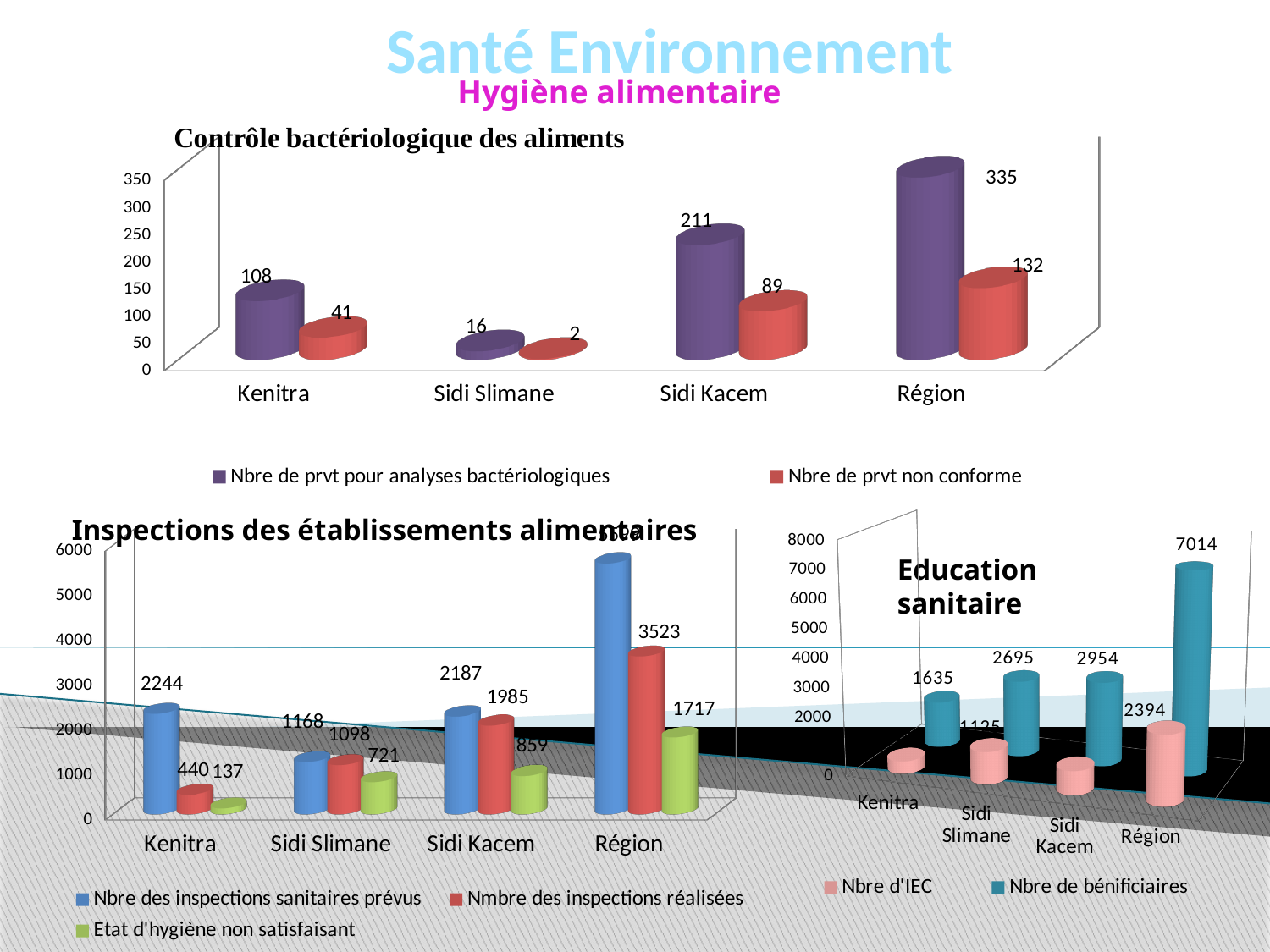
In the 'Education sanitaire' chart, which category has the highest value for 'Nbre de bénificiaires'? Région In the 'Inspections des établissements alimentaires' chart, how many categories are shown on the x axis? 4 In the 'Contrôle bactériologique des aliments' chart, what is the difference between 'Nbre de prvt pour analyses bactériologiques' and 'Nbre de prvt non conforme' for Région? 203 In the 'Contrôle bactériologique des aliments' chart, which category has the lowest value for 'Nbre de prvt pour analyses bactériologiques'? Sidi Slimane What kind of chart is the 'Education sanitaire' chart? Bar chart In the 'Education sanitaire' chart, what is the value of 'Nbre de bénificiaires' for Région? 7014 In the 'Inspections des établissements alimentaires' chart, which is larger for Sidi Kacem: 'Nmbre des inspections réalisées' or 'Etat d'hygiène non satisfaisant'? Nmbre des inspections réalisées In the 'Inspections des établissements alimentaires' chart, what is the value of 'Nbre des inspections sanitaires prévus' for Kenitra? 2244 In the 'Contrôle bactériologique des aliments' chart, how many series does the legend list? 2 In the 'Contrôle bactériologique des aliments' chart, what is the value of 'Nbre de prvt non conforme' for Kenitra? 41 In the 'Contrôle bactériologique des aliments' chart, what is the value of 'Nbre de prvt pour analyses bactériologiques' for Sidi Kacem? 211 In the 'Inspections des établissements alimentaires' chart, what is the value of 'Etat d'hygiène non satisfaisant' for Sidi Slimane? 721